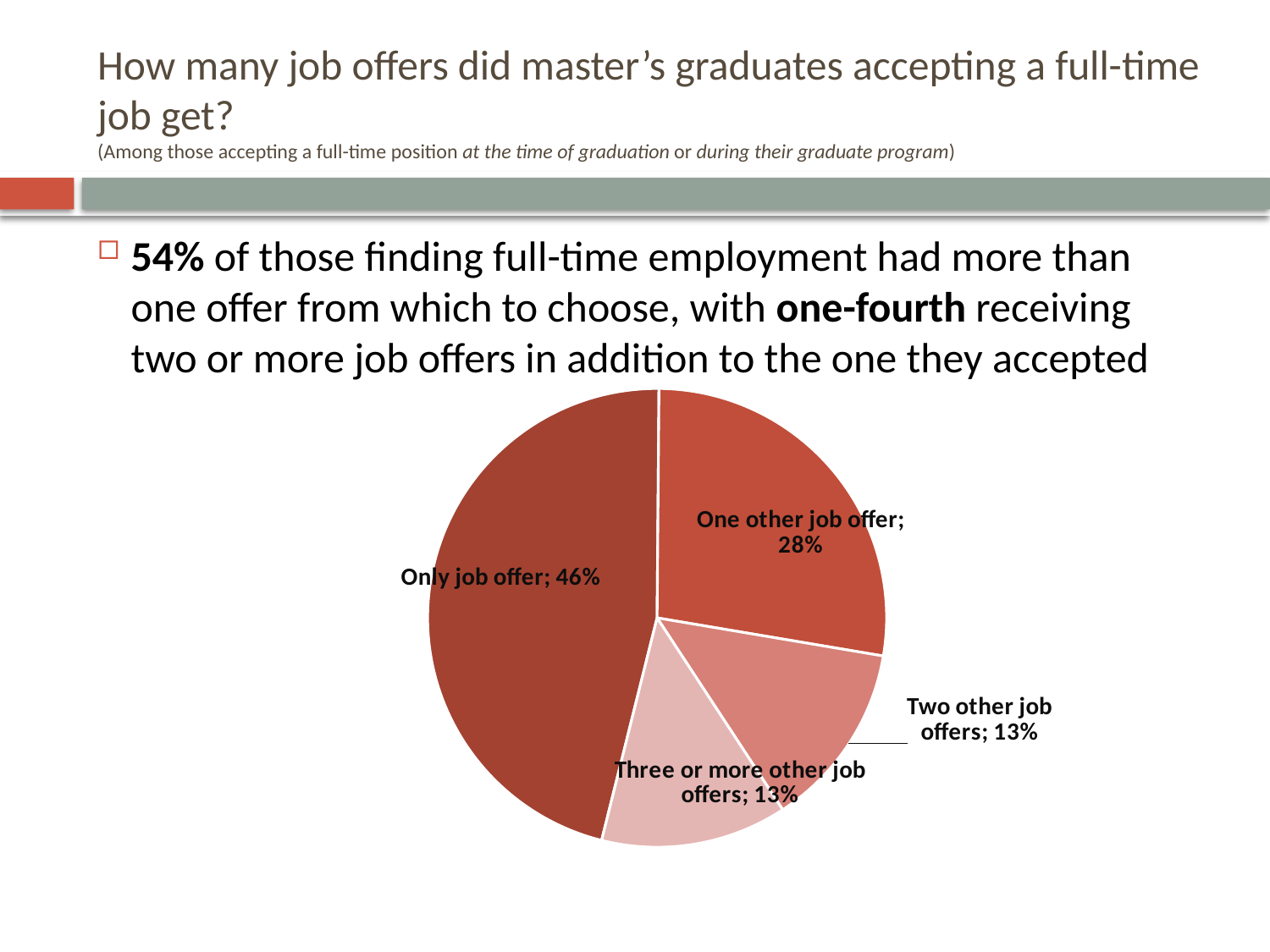
What is the difference between the share for 'Only job offer' and the share for 'One other job offer'? 18 percentage points Which slice of the pie chart is the darkest in colour? Only job offer What percentage of graduates had two other job offers? 13% What percentage of graduates had three or more other job offers? 13% What percentage of graduates had only one job offer? 46% What kind of chart is shown on the slide? pie chart What is the combined share of graduates who had more than one job offer (one other, two other, or three or more other)? 54% What is the combined share of graduates with two other job offers and three or more other job offers? 26% What percentage of graduates had one other job offer? 28% Which is larger: the share for 'Only job offer' or the share for 'One other job offer'? Only job offer How many slices does the pie chart have? 4 Which slice of the pie chart is the largest? Only job offer